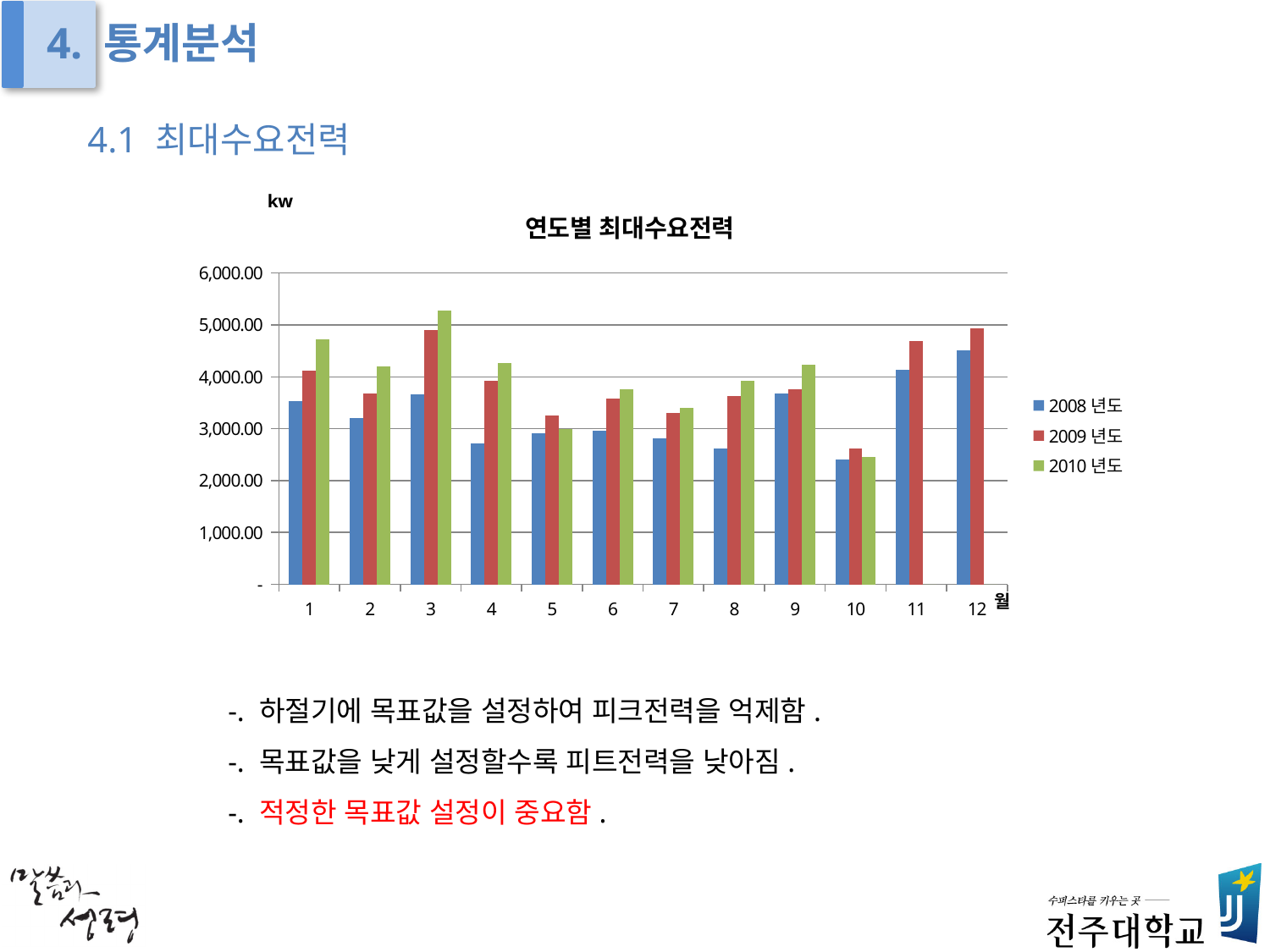
How many series does the legend list? 3 In month 1, which series has the larger value, 2008 년도 or 2010 년도? 2010 년도 In month 4, which series has the larger value, 2008 년도 or 2009 년도? 2009 년도 Which series is shown in green in the legend? 2010 년도 What kind of chart is shown on the slide? Bar chart What is the title of the chart? 연도별 최대수요전력 How many months (categories) are shown on the x axis? 12 Is the value for 2010 년도 in month 3 greater or less than 5,000.00? greater In which month is the value for 2008 년도 the lowest? 10 Is the value for 2009 년도 in month 12 greater or less than 4,000.00? greater Is the value for 2008 년도 in month 10 greater or less than 3,000.00? less In which month is the value for 2010 년도 the highest? 3